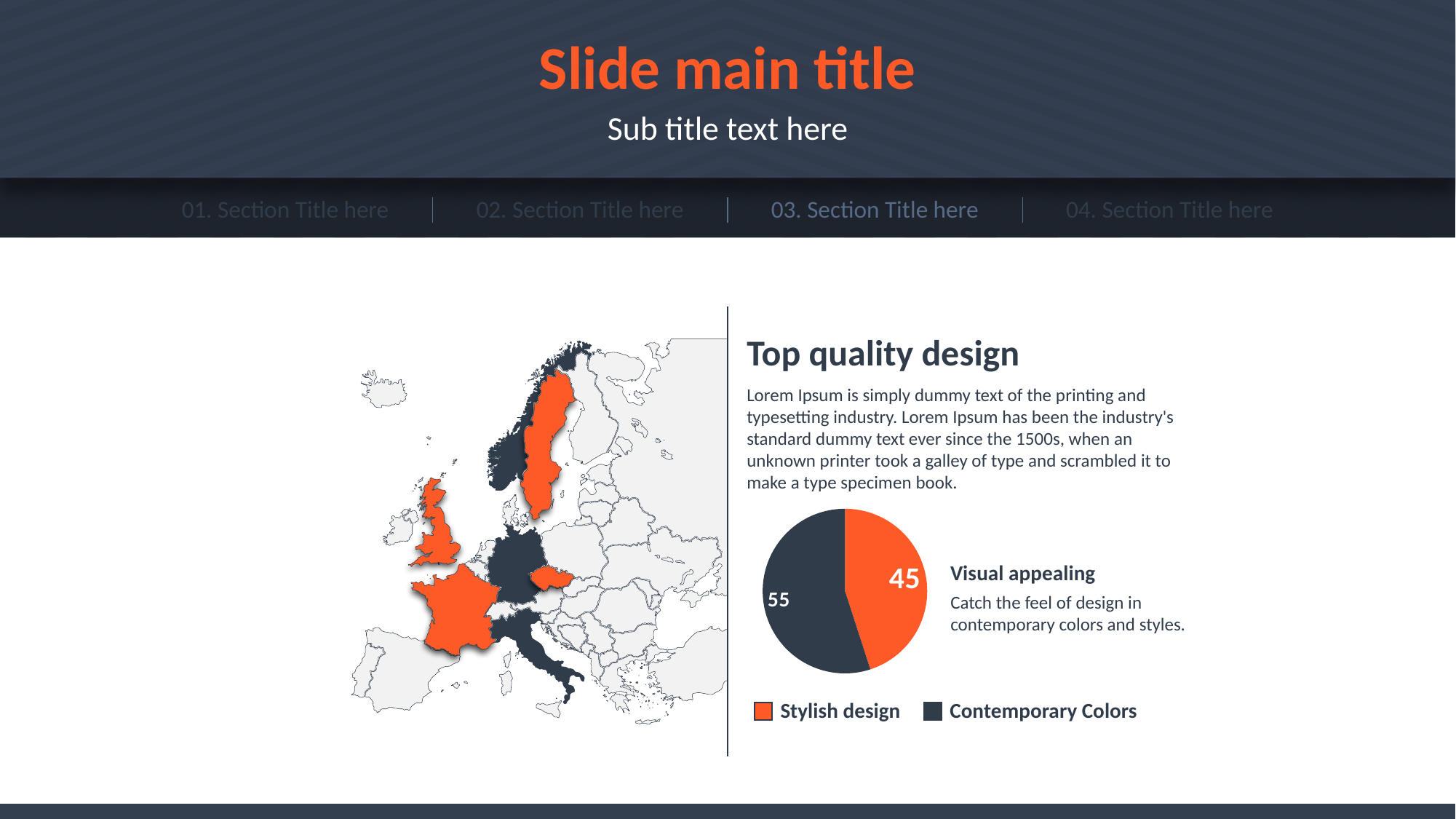
How many entries does the pie chart legend list? 2 What is the total of the two values shown in the pie chart? 100 What is the value for Contemporary Colors in the pie chart? 55 What kind of chart is shown on the slide? pie chart What is the difference between the Contemporary Colors and Stylish design values in the pie chart? 10 Which slice of the pie chart is the largest? Contemporary Colors Which slice of the pie chart is the smallest? Stylish design What share of the pie chart does Stylish design represent? 45% What is the value for Stylish design in the pie chart? 45 Which is larger in the pie chart, Stylish design or Contemporary Colors? Contemporary Colors What colour is the Stylish design slice in the pie chart? orange How many slices does the pie chart have? 2